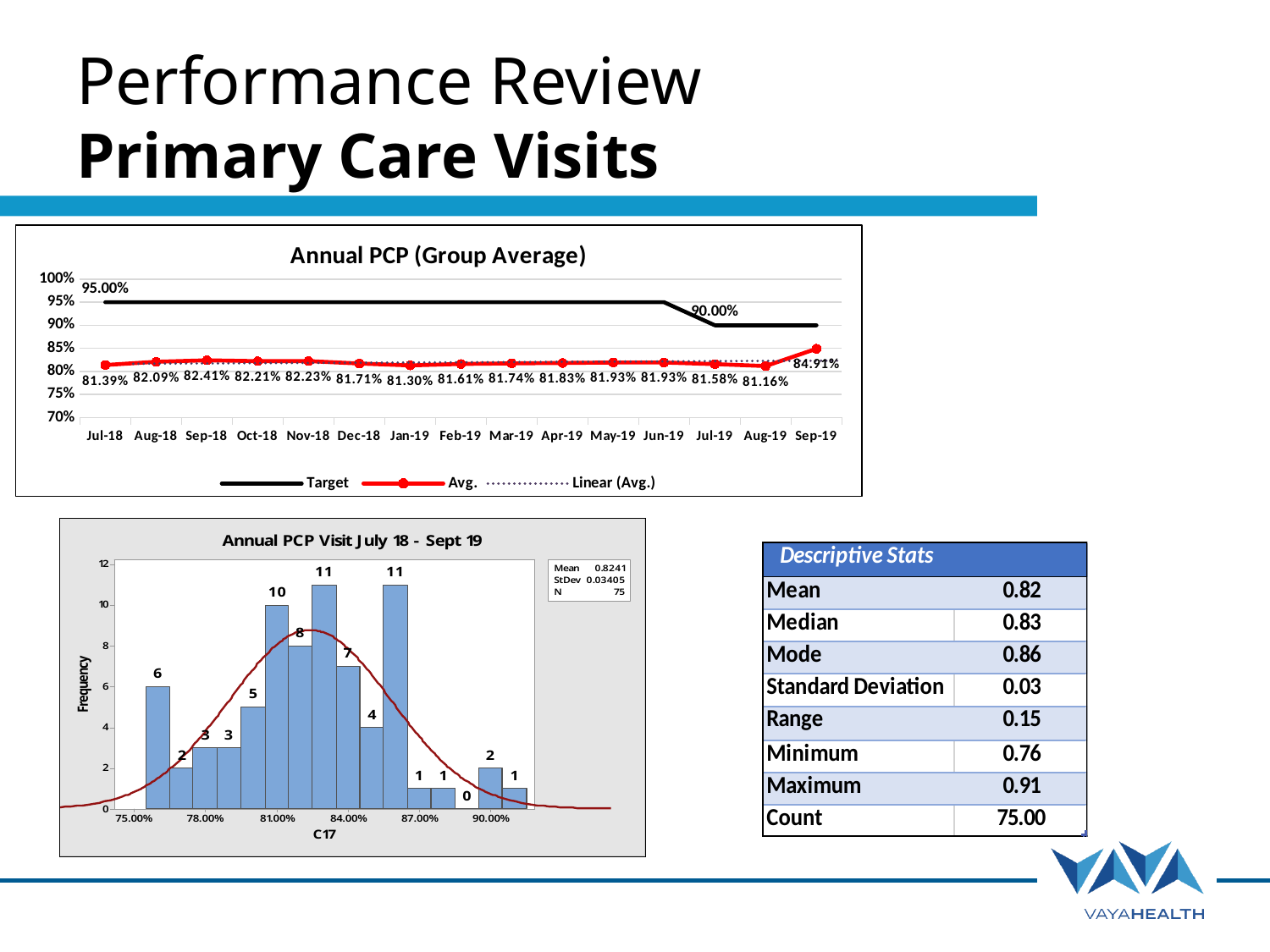
In the 'Annual PCP (Group Average)' chart, what is the Avg. value for Jan-19? 81.30% What kind of chart is 'Annual PCP Visit July 18 - Sept 19'? Bar chart (histogram) In the 'Annual PCP (Group Average)' chart, what Target value is shown from Jul-19 onward? 90.00% In the 'Annual PCP Visit July 18 - Sept 19' chart, what is the highest frequency shown on any bar? 11 In the 'Annual PCP (Group Average)' chart, what is the Avg. value for Sep-19? 84.91% In the 'Annual PCP (Group Average)' chart, what is the difference between the Avg. values for Sep-19 and Aug-19? 3.75% In the 'Annual PCP (Group Average)' chart, which is larger, the Avg. value for Aug-18 or for Dec-18? Aug-18 In the 'Annual PCP (Group Average)' chart, how many months are plotted on the x axis? 15 In the 'Annual PCP (Group Average)' chart, which month has the lowest Avg. value? Aug-19 In the 'Annual PCP Visit July 18 - Sept 19' chart, what N value is shown in the stats box? 75 In the 'Annual PCP (Group Average)' chart, how many series does the legend list? 3 In the 'Annual PCP (Group Average)' chart, which month has the highest Avg. value? Sep-19